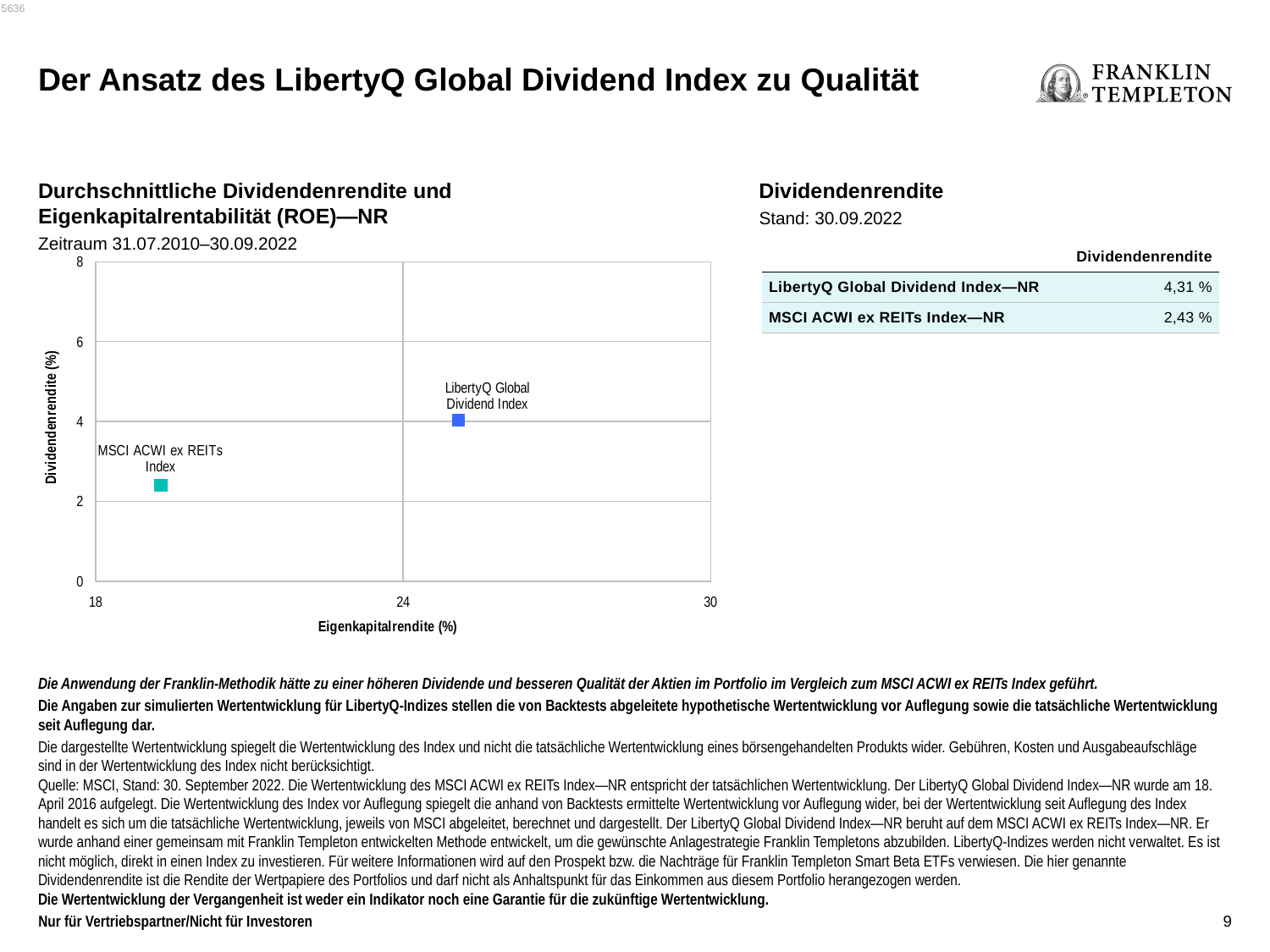
Is the dividend yield (Dividendenrendite) for LibertyQ Global Dividend Index greater or less than 6? less Is the return on equity (Eigenkapitalrendite) for LibertyQ Global Dividend Index greater or less than 24? greater How many data points are plotted on the chart? 2 Is the return on equity (Eigenkapitalrendite) for MSCI ACWI ex REITs Index greater or less than 24? less What time period (Zeitraum) does the chart cover? 31.07.2010–30.09.2022 What kind of chart is shown on the slide? Scatter chart What is the label of the x axis of the chart? Eigenkapitalrendite (%) Which index has the higher dividend yield (Dividendenrendite) on the chart, LibertyQ Global Dividend Index or MSCI ACWI ex REITs Index? LibertyQ Global Dividend Index Which index has the higher return on equity (Eigenkapitalrendite) on the chart? LibertyQ Global Dividend Index